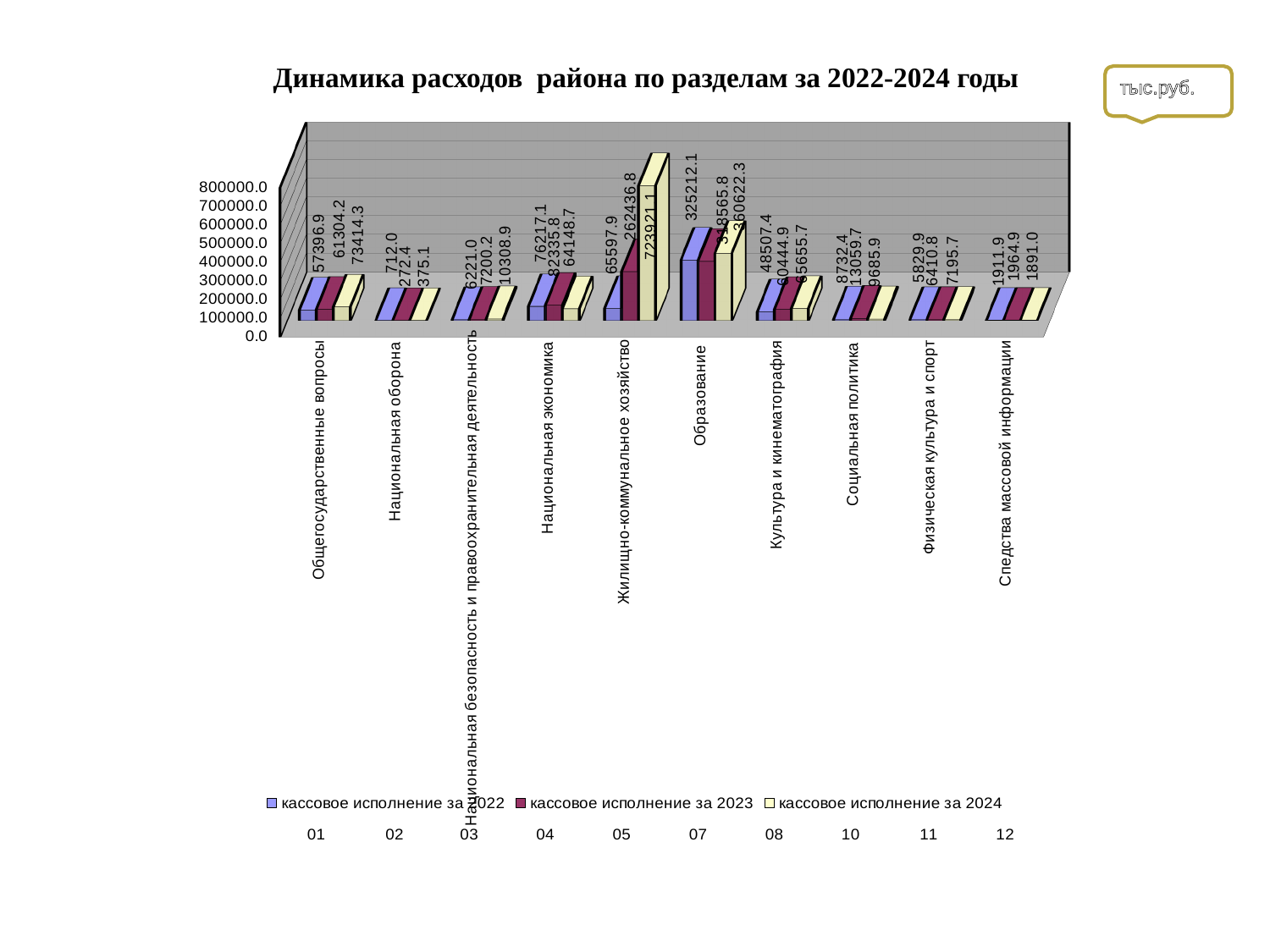
How many series does the legend list? 3 How many categories (sections) are shown on the x axis? 10 Which category has the highest value for кассовое исполнение за 2024? Жилищно-коммунальное хозяйство What is the value for Национальная экономика for кассовое исполнение за 2023? 82335.8 What is the value for Жилищно-коммунальное хозяйство for кассовое исполнение за 2024? 723921.1 Do the values for Национальная безопасность и правоохранительная деятельность rise or fall from 2022 to 2024? rise What is the difference between the 2024 and 2022 values for Общегосударственные вопросы? 16017.4 What is the value for Общегосударственные вопросы for кассовое исполнение за 2022? 57396.9 Which category has the lowest value for кассовое исполнение за 2023? Национальная оборона What kind of chart is shown on the slide? bar chart For Социальная политика, which is larger: the value for 2023 or the value for 2024? кассовое исполнение за 2023 What is the value for Средства массовой информации for кассовое исполнение за 2024? 1891.0